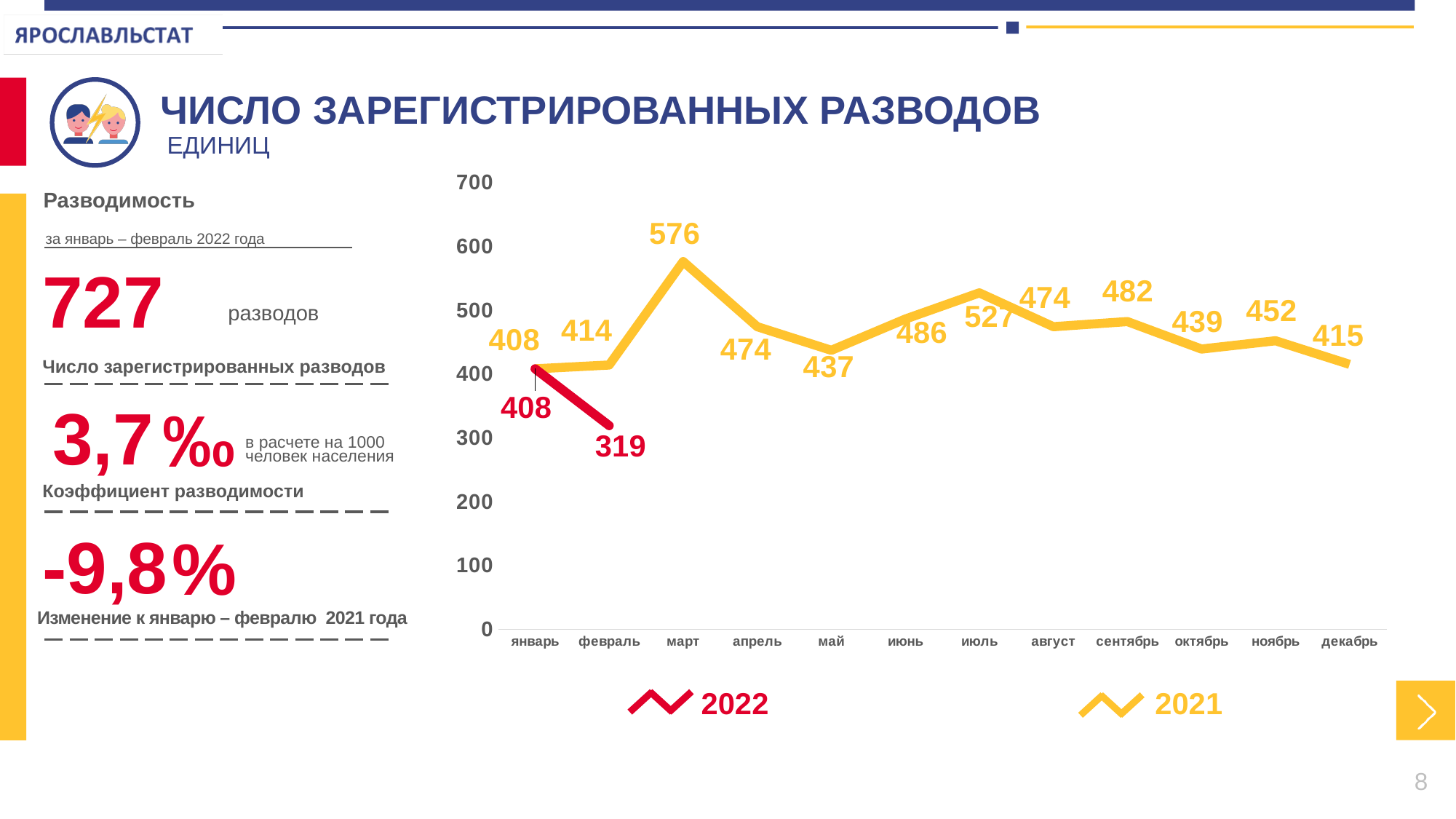
How many months are shown on the x axis? 12 What is the value for июль in the 2021 series? 527 What is the value for февраль in the 2022 series? 319 What colour is the 2021 series line? yellow What kind of chart is shown on the slide? line chart Which month has the lowest value in the 2021 series? январь Does the 2022 series rise or fall from январь to февраль? fall What is the difference between the 2021 and 2022 values for февраль? 95 What is the value for март in the 2021 series? 576 Which month has the highest value in the 2021 series? март Which is larger in the 2021 series: the value for сентябрь or the value for октябрь? сентябрь How many series does the legend list? 2